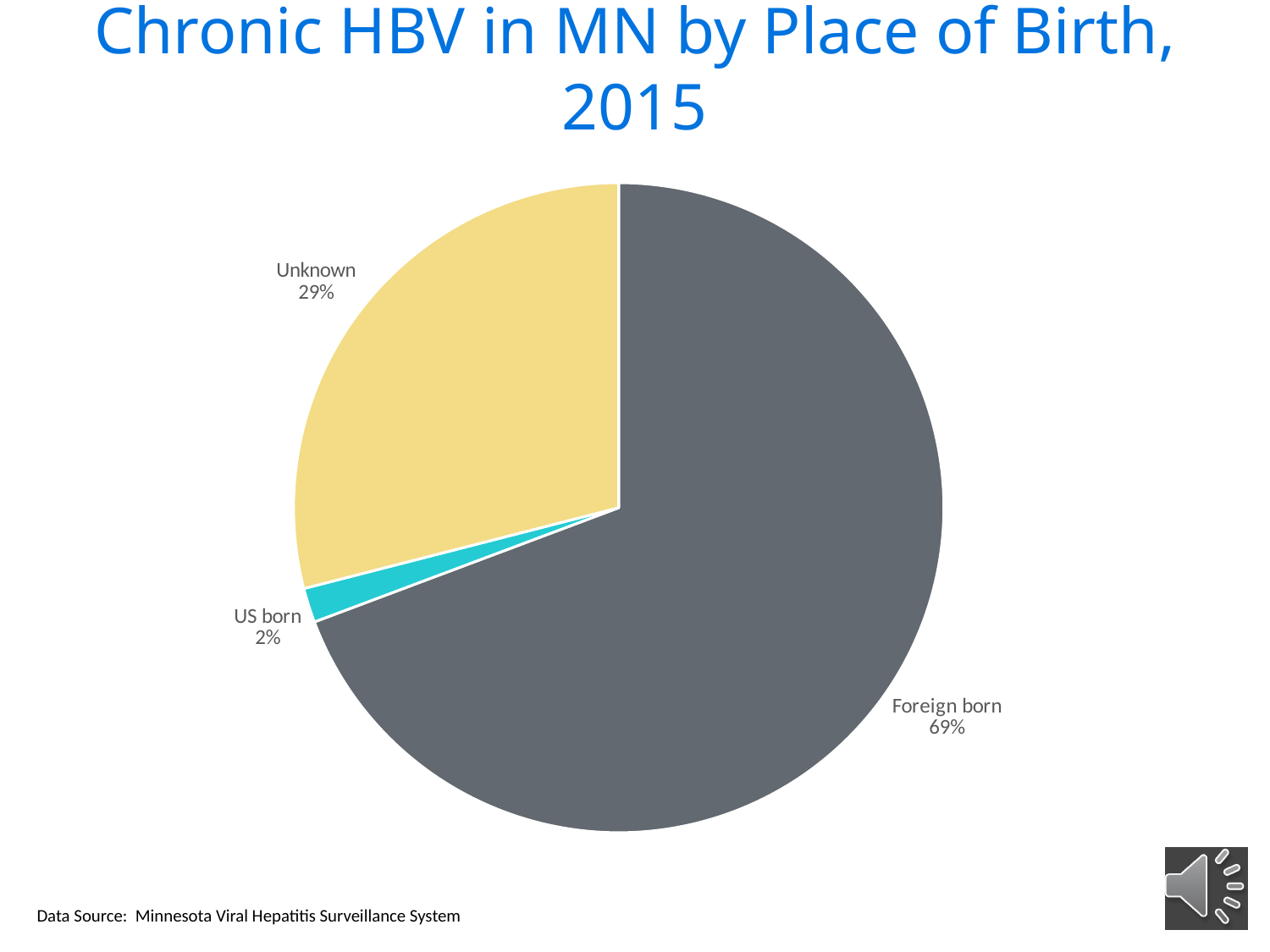
What is the title of the chart? Chronic HBV in MN by Place of Birth, 2015 What share of chronic HBV cases is labelled Foreign born? 69% What kind of chart is shown on the slide? pie chart What share of chronic HBV cases is labelled US born? 2% What is the difference in percentage points between the Foreign born and Unknown slices? 40 Which is larger, the Unknown slice or the US born slice? Unknown Which place-of-birth category has the smallest slice? US born Which place-of-birth category has the largest slice? Foreign born What colour is the Foreign born slice? grey What is the difference in percentage points between the Unknown and US born slices? 27 How many slices does the pie chart have? 3 What share of chronic HBV cases is labelled Unknown? 29%